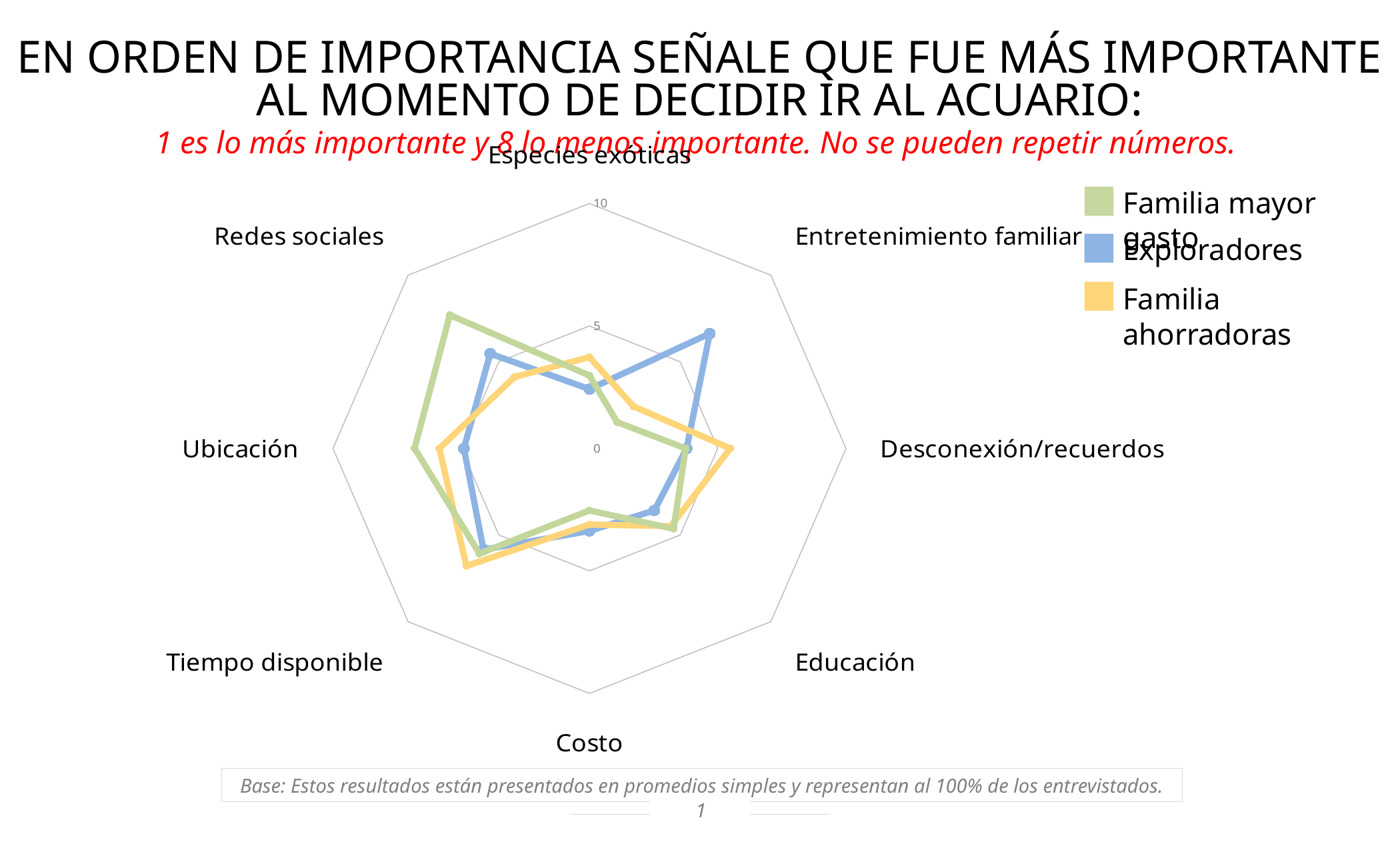
Is the value for Familia mayor gasto at Especies exóticas greater or less than 5? less Is the value for Familia mayor gasto at Ubicación greater or less than 5? greater At Entretenimiento familiar, which series has the larger value: Exploradores or Familia mayor gasto? Exploradores How many categories (axes) does the radar chart have? 8 Which colour represents the Exploradores series in the legend? Blue Is the value for Familia mayor gasto at Redes sociales greater or less than 5? greater What kind of chart is shown on the slide? Radar chart At Redes sociales, which series has the larger value: Familia mayor gasto or Exploradores? Familia mayor gasto How many series does the legend list? 3